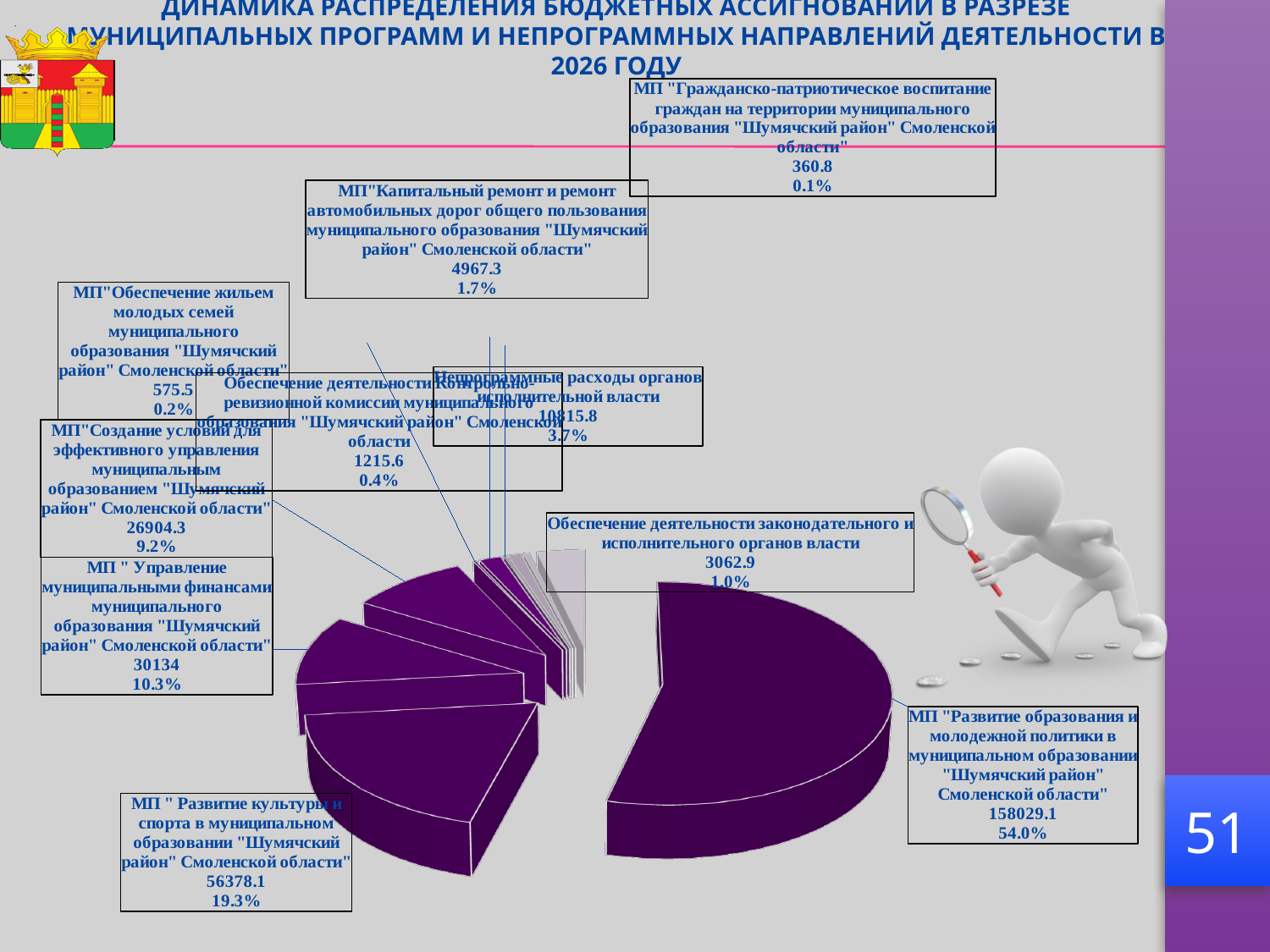
What value is shown for МП "Развитие культуры и спорта"? 56378.1 How many slices does the pie chart have? 10 Which is larger: the value for МП "Управление муниципальными финансами" or for МП "Создание условий для эффективного управления"? МП "Управление муниципальными финансами" What percentage is shown for Непрограммные расходы органов исполнительной власти? 3.7% What share of the pie does МП "Развитие образования и молодежной политики" take? 54.0% What is the difference between the values for МП "Развитие образования и молодежной политики" and МП "Развитие культуры и спорта"? 101651 What kind of chart is shown on the slide? pie chart What value is shown for МП "Развитие образования и молодежной политики"? 158029.1 What value is shown for МП "Гражданско-патриотическое воспитание граждан"? 360.8 Which category has the largest slice of the pie? МП "Развитие образования и молодежной политики в муниципальном образовании "Шумячский район" Смоленской области" Which category has the smallest slice of the pie? МП "Гражданско-патриотическое воспитание граждан на территории муниципального образования "Шумячский район" Смоленской области" What percentage is shown for МП "Управление муниципальными финансами"? 10.3%